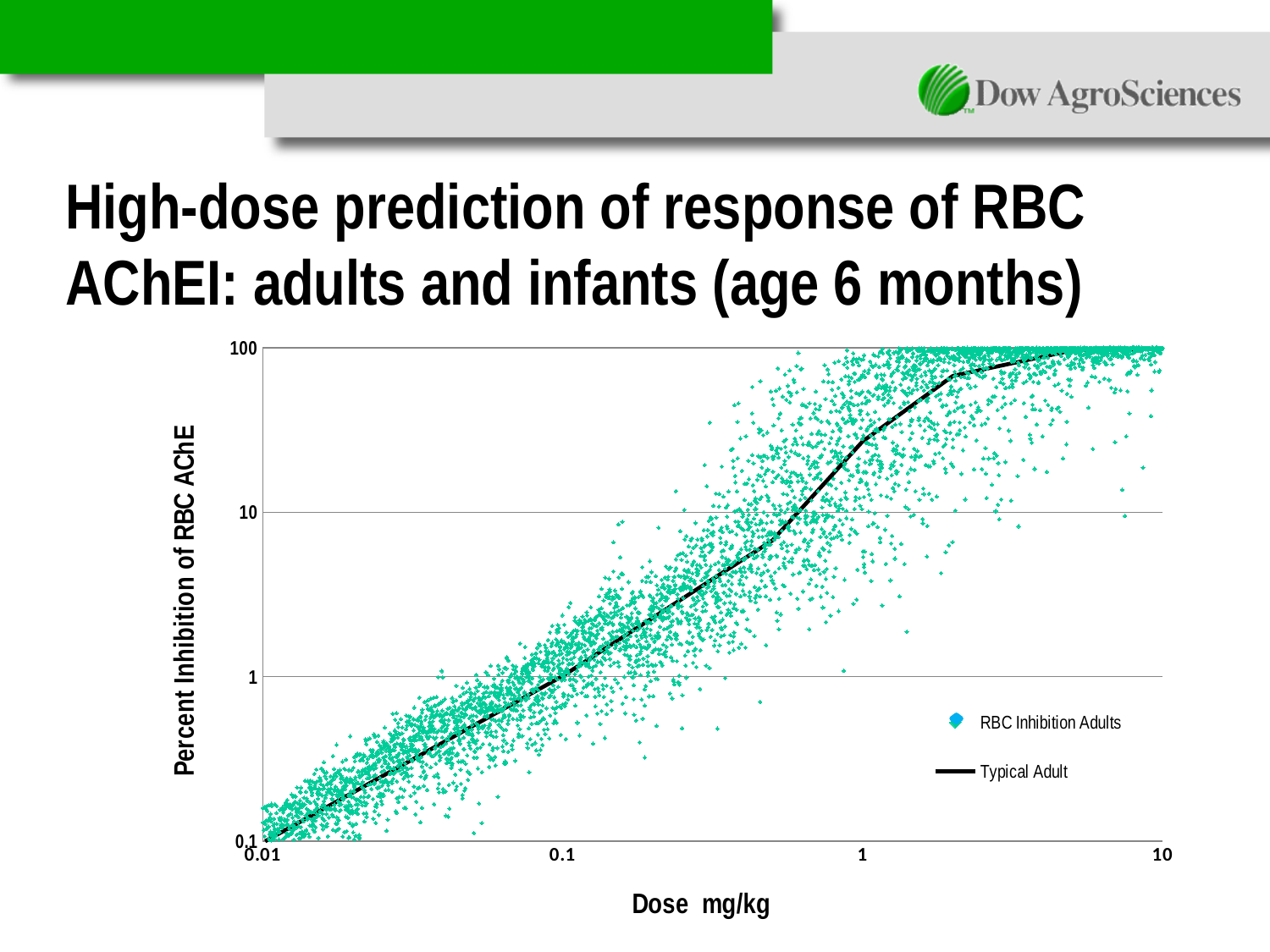
What are the two series named in the chart legend? RBC Inhibition Adults and Typical Adult Does the Typical Adult line rise or fall as dose increases along the x axis? rise How many series does the chart legend list? 2 What is the lowest dose value shown on the x axis of the chart? 0.01 What is the label of the x axis of the chart? Dose mg/kg What kind of chart is shown on the slide? scatter plot Is the Typical Adult value at a dose of 1 mg/kg greater or less than 10 percent inhibition? greater Is the Typical Adult value at a dose of 1 mg/kg greater or less than 100 percent inhibition? less